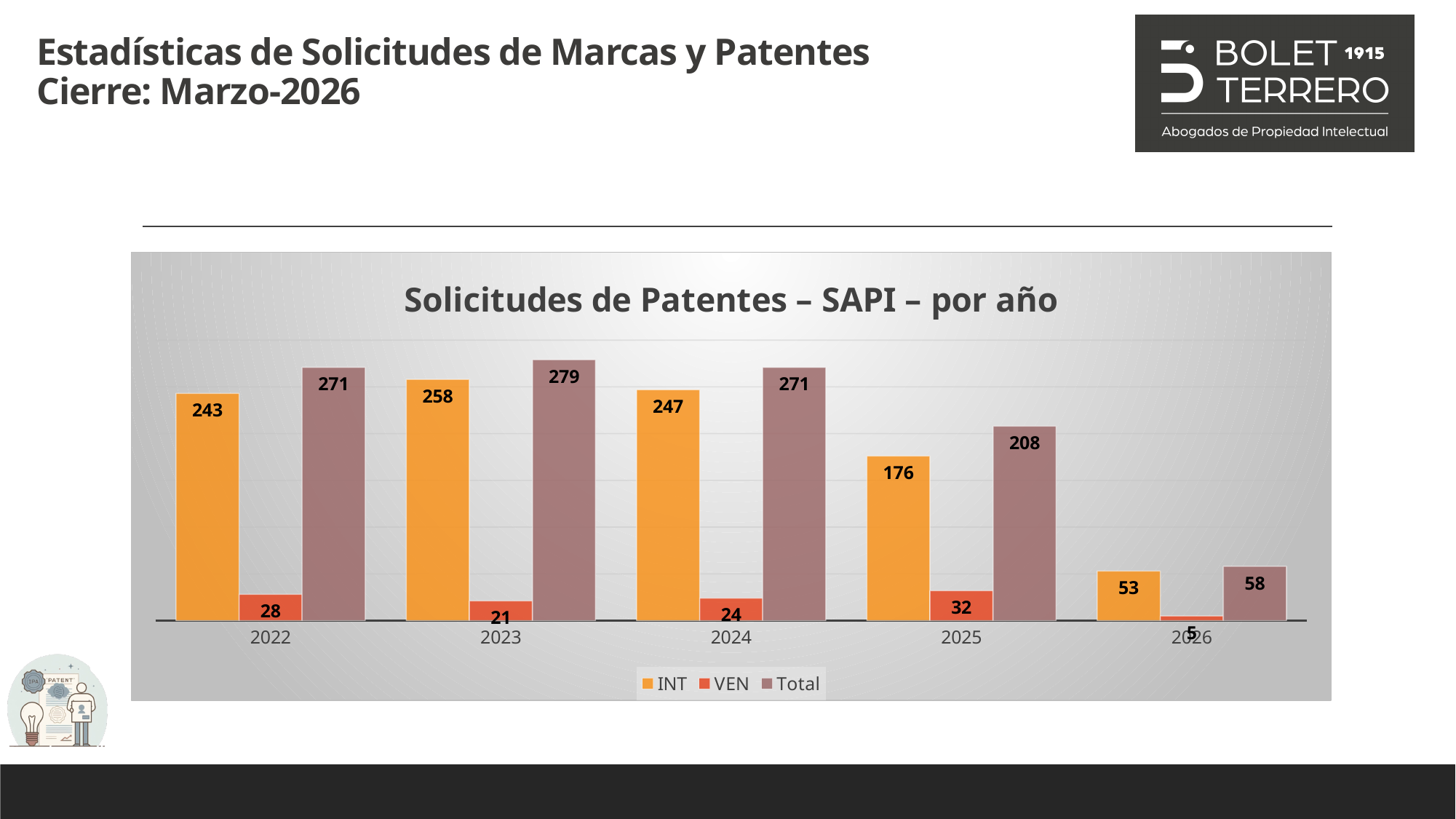
What is the title of the chart? Solicitudes de Patentes – SAPI – por año What is the VEN value for 2025? 32 What is the Total value for 2026? 58 Which year has the lowest INT value? 2026 What kind of chart is shown? Bar chart What is the INT value for 2023? 258 How many years are shown on the x axis? 5 Does the Total value rise or fall from 2023 to 2026? Fall How many series does the legend list? 3 Which year has the highest Total value? 2023 What is the difference between the Total values for 2024 and 2025? 63 Which is larger, the VEN value for 2022 or the VEN value for 2024? 2022